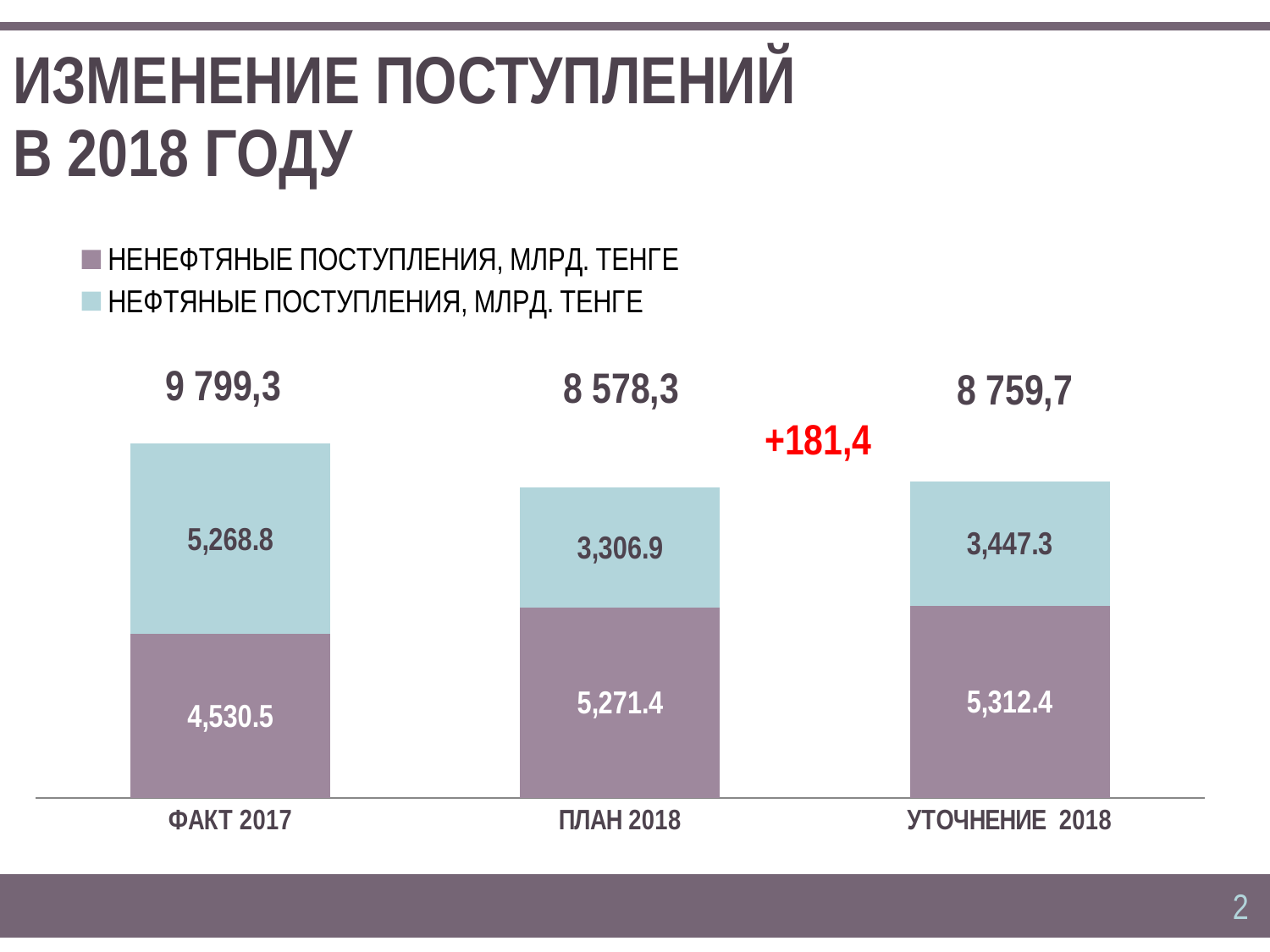
How many categories are shown on the x axis? 3 How many series does the legend list? 2 What is the total of the stacked bar for УТОЧНЕНИЕ 2018? 8 759,7 Which is larger for ПЛАН 2018: НЕНЕФТЯНЫЕ ПОСТУПЛЕНИЯ or НЕФТЯНЫЕ ПОСТУПЛЕНИЯ? НЕНЕФТЯНЫЕ ПОСТУПЛЕНИЯ Which category has the highest value for НЕФТЯНЫЕ ПОСТУПЛЕНИЯ? ФАКТ 2017 What is the difference between the НЕНЕФТЯНЫЕ ПОСТУПЛЕНИЯ values for УТОЧНЕНИЕ 2018 and ПЛАН 2018? 41.0 What is the total of the stacked bar for ФАКТ 2017? 9 799,3 What is the value of НЕНЕФТЯНЫЕ ПОСТУПЛЕНИЯ for ФАКТ 2017? 4,530.5 What is the value of НЕФТЯНЫЕ ПОСТУПЛЕНИЯ for УТОЧНЕНИЕ 2018? 3,447.3 What is the difference between the НЕФТЯНЫЕ ПОСТУПЛЕНИЯ values for ФАКТ 2017 and ПЛАН 2018? 1,961.9 What is the value of НЕФТЯНЫЕ ПОСТУПЛЕНИЯ for ПЛАН 2018? 3,306.9 Which category has the lowest value for НЕФТЯНЫЕ ПОСТУПЛЕНИЯ? ПЛАН 2018